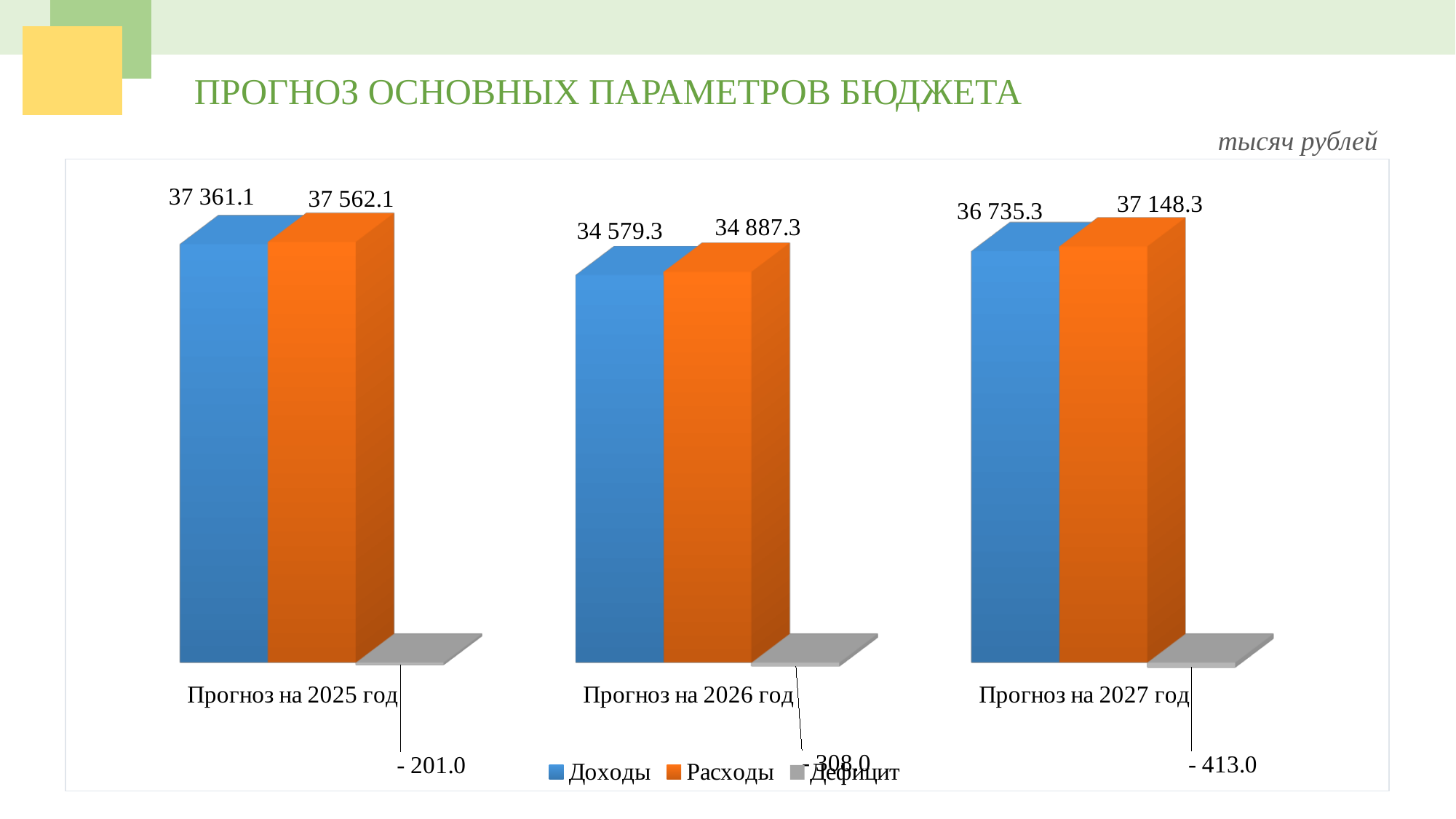
What is the value of Расходы for Прогноз на 2026 год? 34 887.3 How many forecast years (categories) are shown on the chart? 3 Which is larger for Прогноз на 2025 год, Доходы or Расходы? Расходы How many series does the legend list? 3 What is the value of Расходы for Прогноз на 2027 год? 37 148.3 What kind of chart is shown on the slide? Bar chart Which forecast year has the lowest value of Расходы? Прогноз на 2026 год What is the value of Дефицит for Прогноз на 2027 год? - 413.0 What is the difference between Расходы and Доходы for Прогноз на 2027 год? 413.0 What is the value of Доходы for Прогноз на 2025 год? 37 361.1 What is the value of Дефицит for Прогноз на 2025 год? - 201.0 Which forecast year has the highest value of Доходы? Прогноз на 2025 год